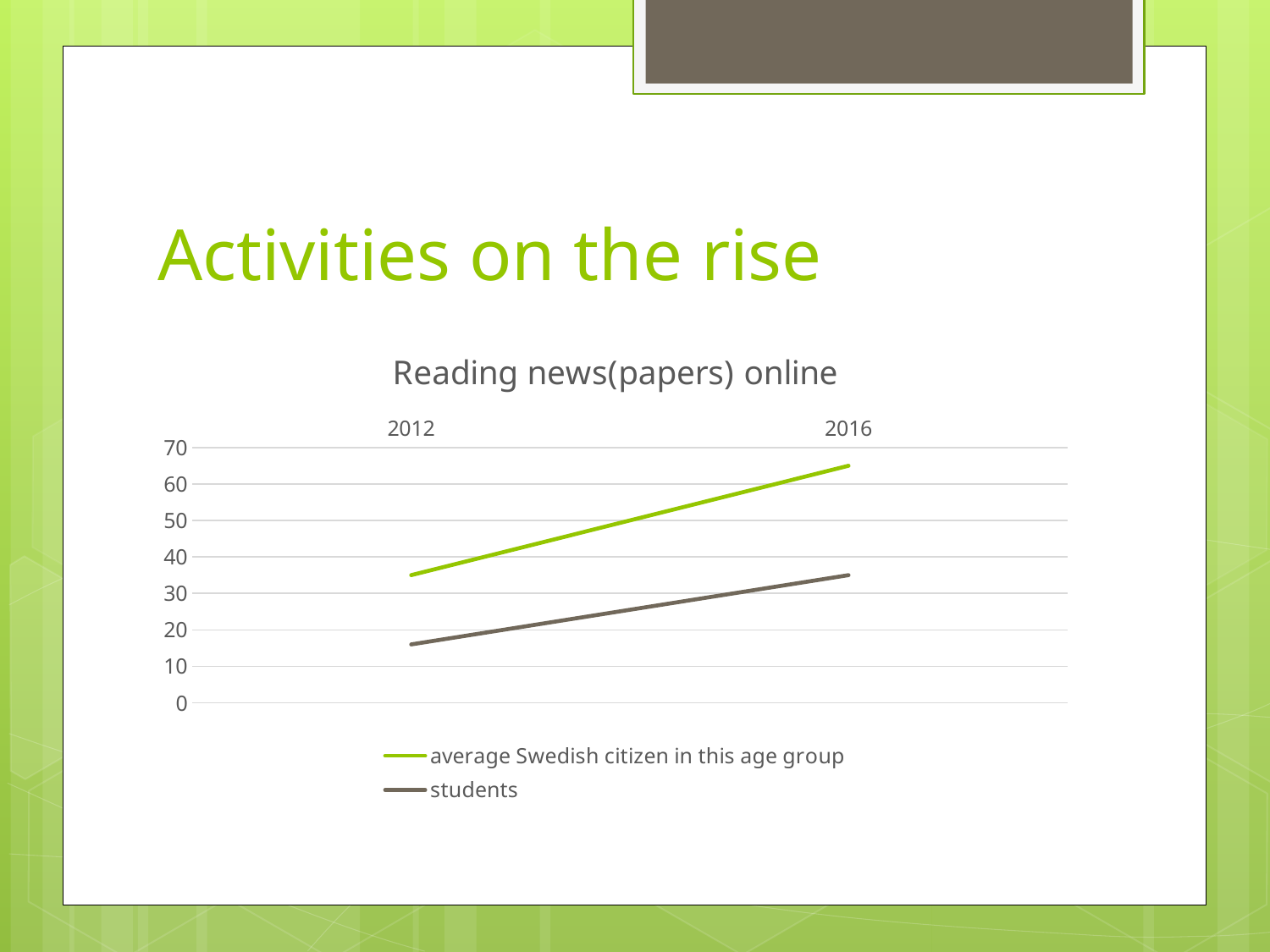
What is the title of the chart? Reading news(papers) online How many years are shown on the x axis? 2 Is the value for the average Swedish citizen in this age group in 2012 greater or less than 40? less Which series is shown in green in the legend? average Swedish citizen in this age group Does the value for the average Swedish citizen in this age group rise or fall from 2012 to 2016? rise Is the value for students in 2012 greater or less than 20? less How many series does the legend list? 2 In 2016, which series has the higher value: average Swedish citizen in this age group or students? average Swedish citizen in this age group Does the value for students rise or fall from 2012 to 2016? rise Is the value for the average Swedish citizen in this age group in 2016 greater or less than 60? greater In 2012, which series has the lower value: average Swedish citizen in this age group or students? students What kind of chart is shown on the slide? line chart